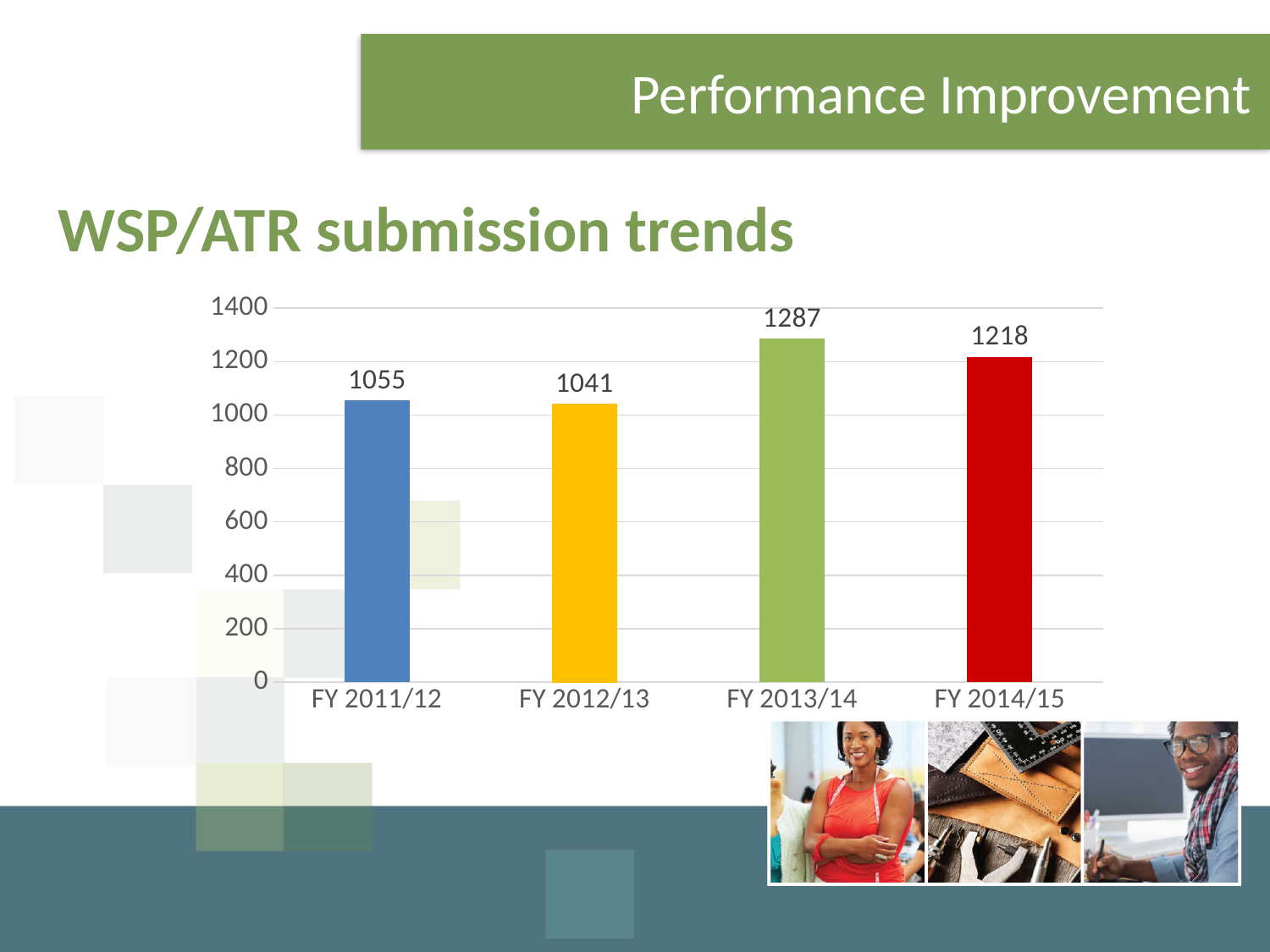
What is the value for FY 2014/15? 1218 What is the title of the chart? WSP/ATR submission trends Which fiscal year has the highest value? FY 2013/14 What kind of chart is shown on the slide? bar chart Which fiscal year has the lowest value? FY 2012/13 What is the difference between the values for FY 2013/14 and FY 2014/15? 69 What is the difference between the values for FY 2011/12 and FY 2012/13? 14 What is the value for FY 2011/12? 1055 How many fiscal years are shown on the chart? 4 Is the value for FY 2013/14 greater or less than 1200? greater Which is larger, the value for FY 2014/15 or the value for FY 2011/12? FY 2014/15 What is the value for FY 2013/14? 1287